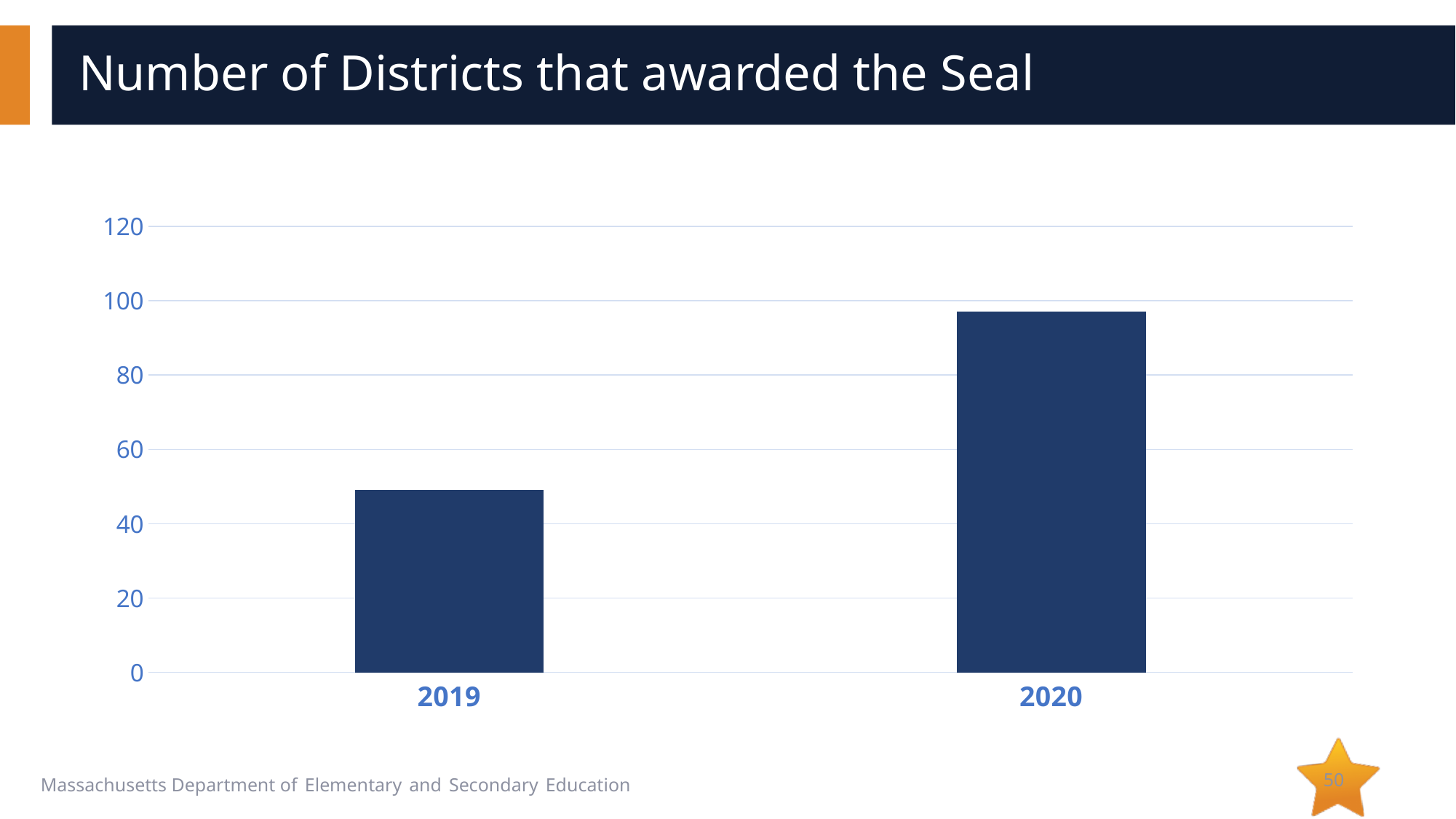
Which is larger, the value for 2019 or the value for 2020? 2020 Is the value for 2019 greater or less than 60? less Which year has the lowest number of districts that awarded the Seal? 2019 Do the values rise or fall from 2019 to 2020? rise How many categories are shown on the x axis of the chart? 2 Is the value for 2020 greater or less than 80? greater Is the value for 2019 greater or less than 40? greater What is the title of the slide containing the chart? Number of Districts that awarded the Seal What kind of chart is shown on the slide? bar chart What is the highest value shown on the y axis of the chart? 120 Which year has the highest number of districts that awarded the Seal? 2020